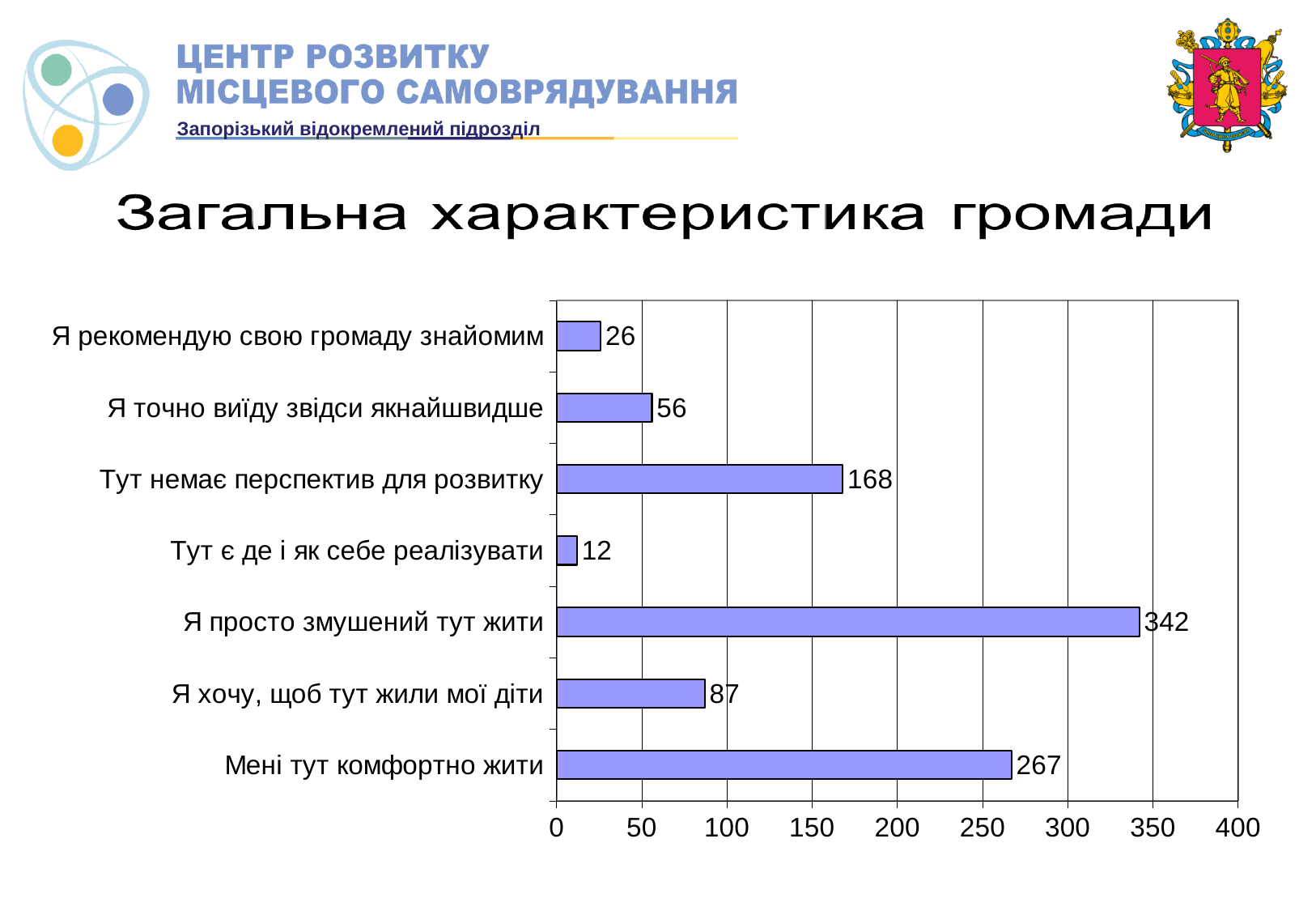
What is the value for "Я рекомендую свою громаду знайомим"? 26 Is the value for "Тут немає перспектив для розвитку" greater or less than 150? greater How many categories are shown in the chart? 7 What is the title of the slide? Загальна характеристика громади What is the difference between the values for "Я просто змушений тут жити" and "Мені тут комфортно жити"? 75 What is the value for "Я просто змушений тут жити"? 342 What is the value for "Тут немає перспектив для розвитку"? 168 Which is larger: the value for "Я хочу, щоб тут жили мої діти" or "Я точно виїду звідси якнайшвидше"? Я хочу, щоб тут жили мої діти What kind of chart is shown on the slide? bar chart Which category has the lowest value? Тут є де і як себе реалізувати Which category has the highest value? Я просто змушений тут жити What is the value for "Мені тут комфортно жити"? 267